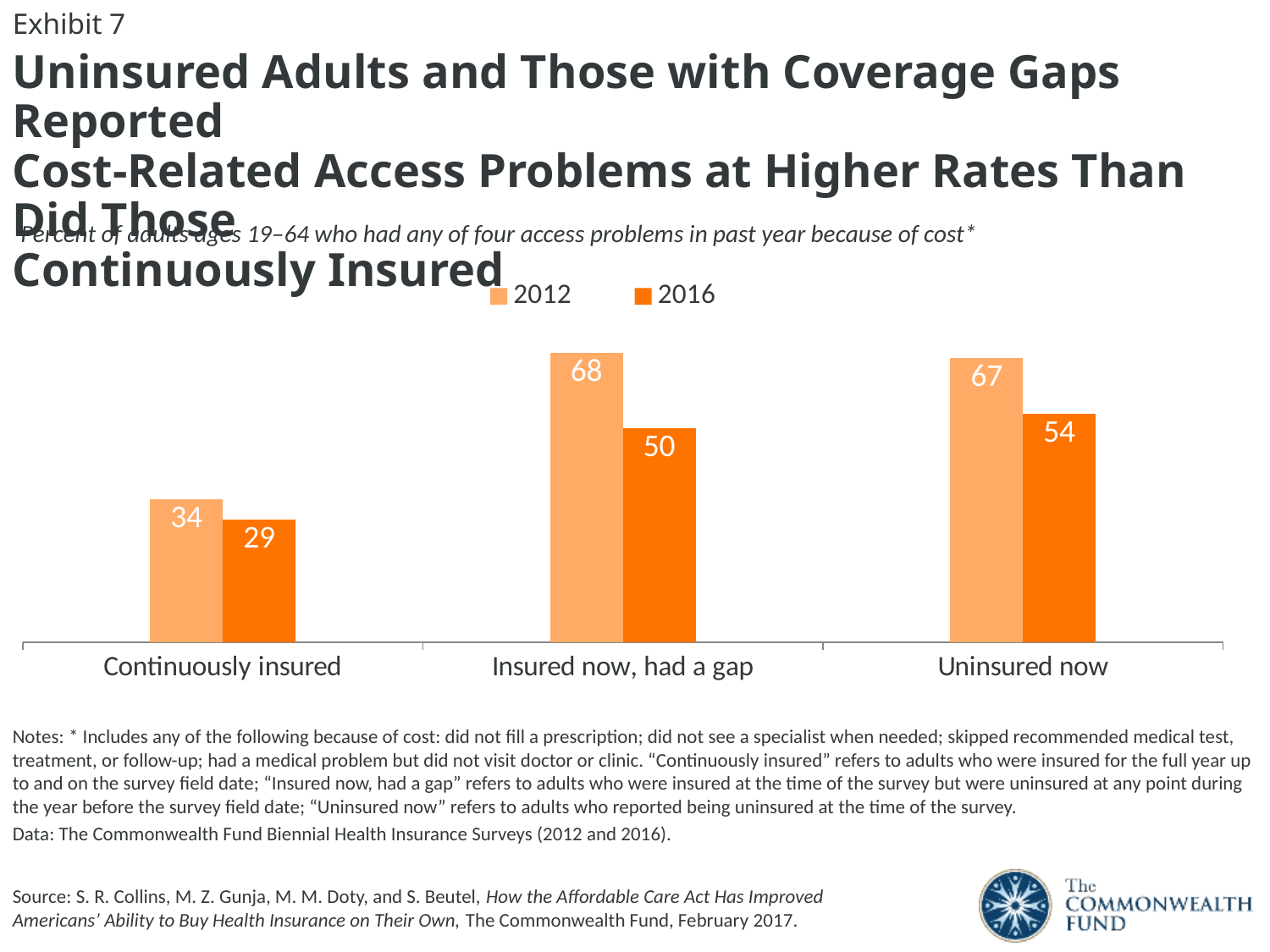
Which category had the highest value in 2012? Insured now, had a gap What was the value for 'Continuously insured' in 2012? 34 What was the value for 'Insured now, had a gap' in 2016? 50 What kind of chart is shown on the slide? Bar chart Which category had the lowest value in 2016? Continuously insured Which years are listed in the legend? 2012 and 2016 What was the value for 'Uninsured now' in 2012? 67 What is the difference between the 2012 and 2016 values for 'Insured now, had a gap'? 18 What is the difference between the 2012 and 2016 values for 'Uninsured now'? 13 Which is larger: the 2016 value for 'Uninsured now' or the 2016 value for 'Insured now, had a gap'? Uninsured now How many series does the legend list? 2 How many categories are shown on the x axis? 3